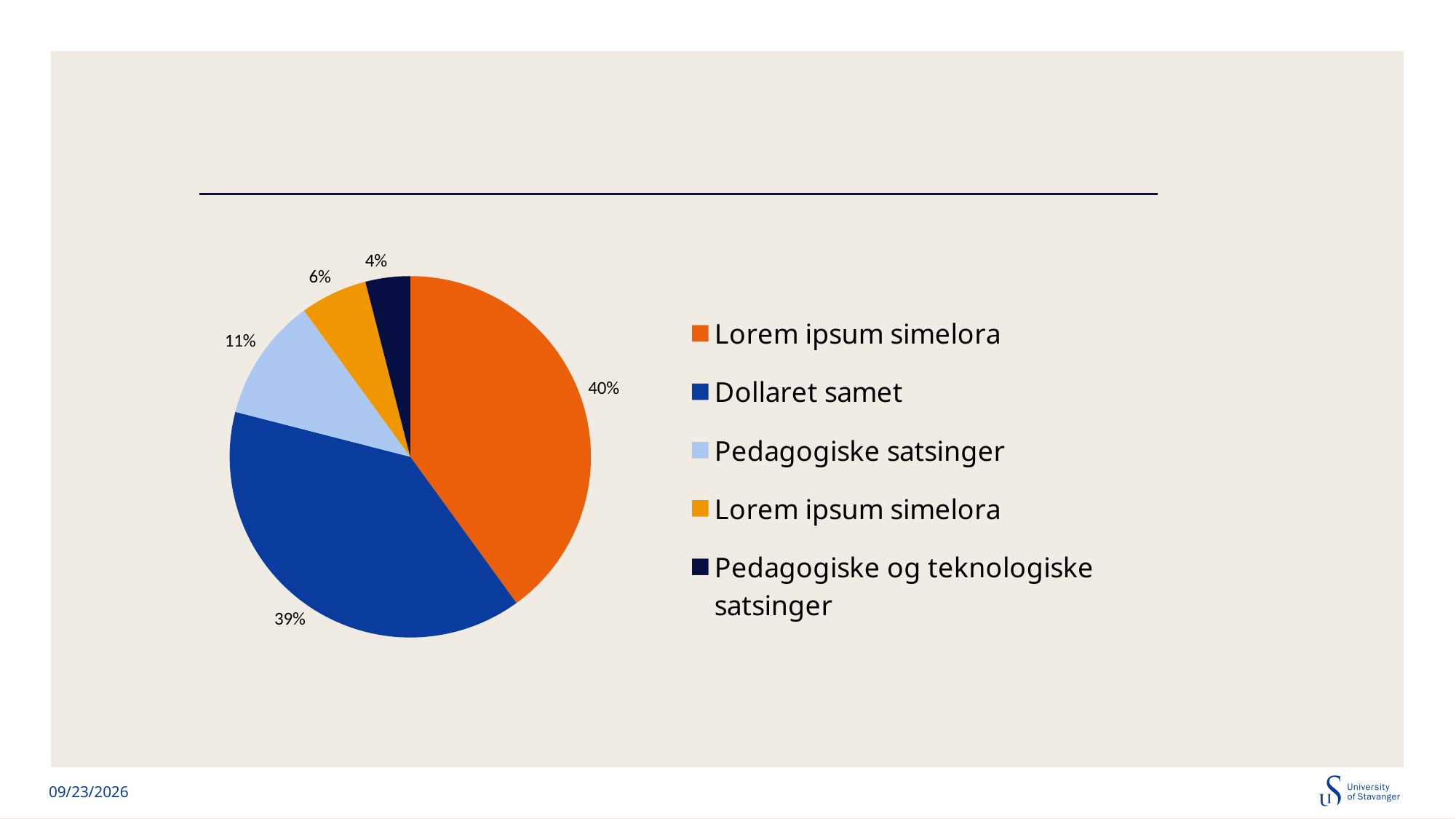
What colour is the Pedagogiske satsinger slice in the pie chart? light blue What percentage does the Pedagogiske og teknologiske satsinger slice represent? 4% What percentage does the yellow Lorem ipsum simelora slice represent? 6% Which is larger, the Dollaret samet slice or the Pedagogiske satsinger slice? Dollaret samet What is the difference in percentage points between the Dollaret samet slice and the Pedagogiske satsinger slice? 28 What percentage does the Pedagogiske satsinger slice represent? 11% How many slices does the pie chart have? 5 Which category has the smallest slice of the pie chart? Pedagogiske og teknologiske satsinger What kind of chart is shown on the slide? pie chart What percentage does the orange Lorem ipsum simelora slice represent? 40% What percentage does the Dollaret samet slice represent? 39% How many entries does the legend of the pie chart list? 5